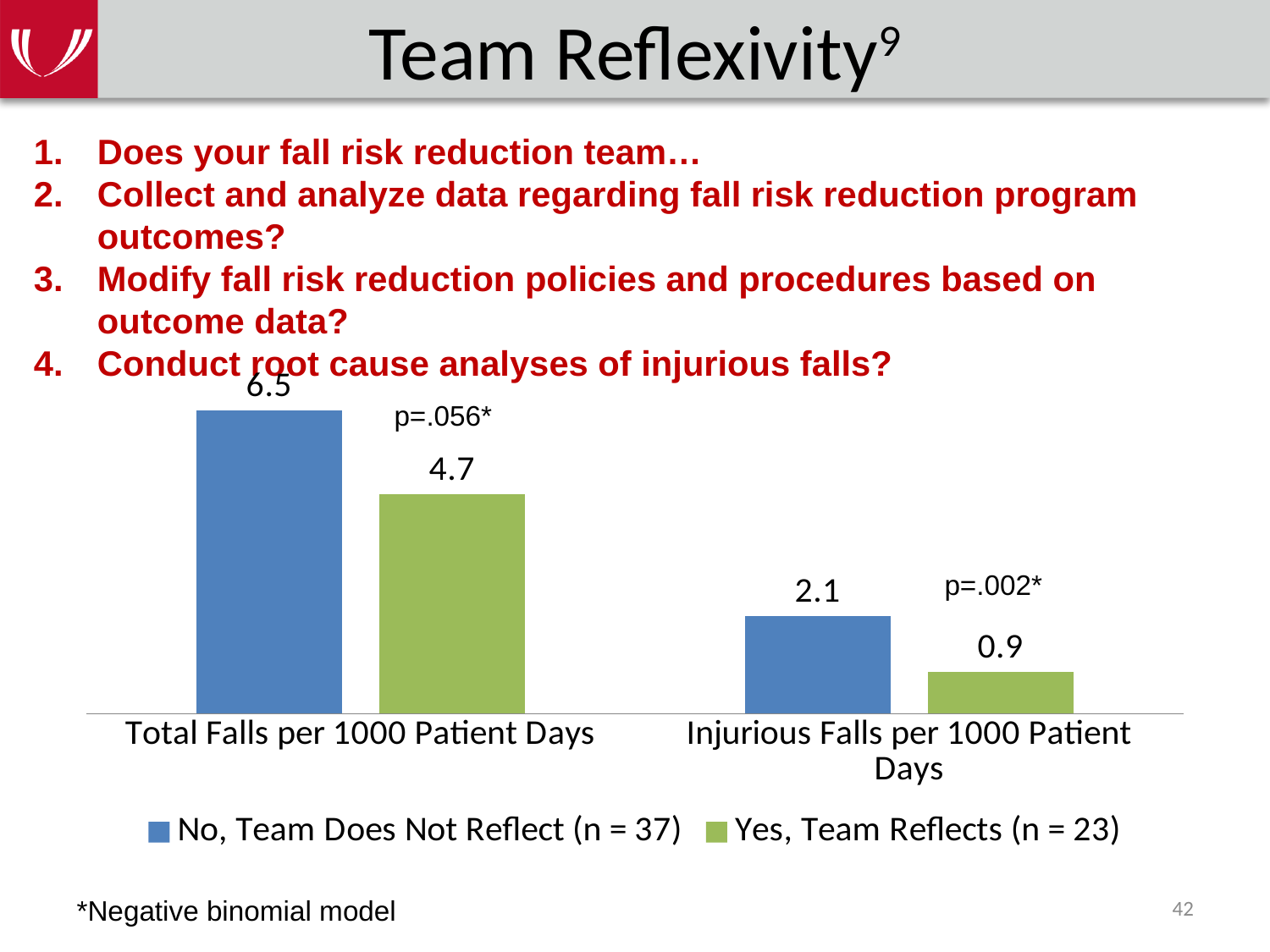
For Injurious Falls per 1000 Patient Days, which series has the larger value: 'No, Team Does Not Reflect' or 'Yes, Team Reflects'? No, Team Does Not Reflect How many series does the legend list? 2 What is the value for 'No, Team Does Not Reflect (n = 37)' for Total Falls per 1000 Patient Days? 6.5 What is the difference between the 'No, Team Does Not Reflect' and 'Yes, Team Reflects' values for Total Falls per 1000 Patient Days? 1.8 Which bar has the lowest value in the chart? Yes, Team Reflects (n = 23) for Injurious Falls per 1000 Patient Days What is the difference between the 'No, Team Does Not Reflect' and 'Yes, Team Reflects' values for Injurious Falls per 1000 Patient Days? 1.2 What is the value for 'No, Team Does Not Reflect (n = 37)' for Injurious Falls per 1000 Patient Days? 2.1 What is the value for 'Yes, Team Reflects (n = 23)' for Total Falls per 1000 Patient Days? 4.7 How many categories are shown on the x axis of the chart? 2 Which bar has the highest value in the chart? No, Team Does Not Reflect (n = 37) for Total Falls per 1000 Patient Days What is the value for 'Yes, Team Reflects (n = 23)' for Injurious Falls per 1000 Patient Days? 0.9 What kind of chart is shown on the slide? Bar chart